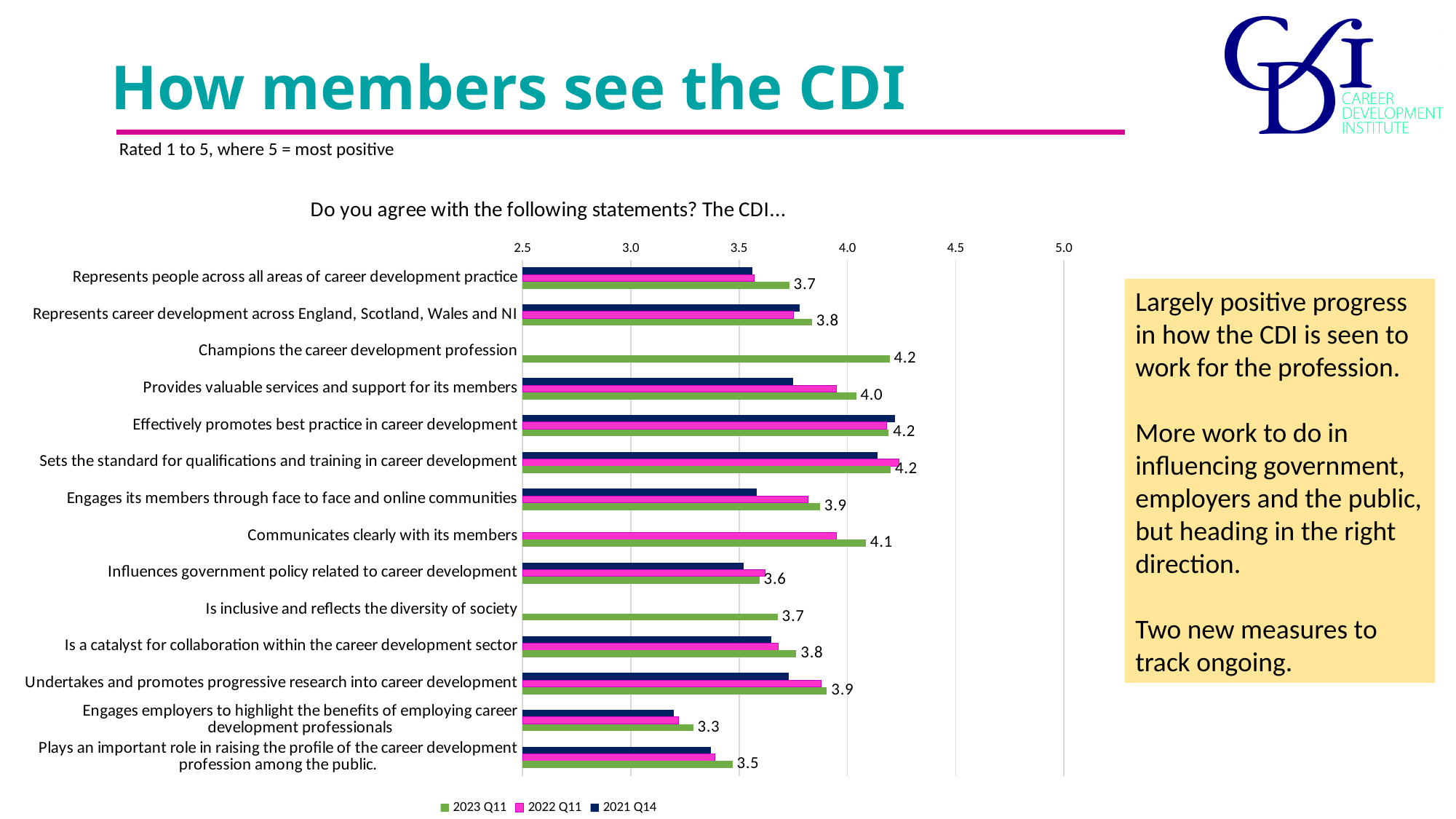
How many series does the legend list? 3 What is the difference between the 2023 Q11 values for "Communicates clearly with its members" and "Influences government policy related to career development"? 0.5 What is the 2023 Q11 value for "Champions the career development profession"? 4.2 How many statements are listed on the chart? 14 Which statement has the lowest 2023 Q11 value? Engages employers to highlight the benefits of employing career development professionals What is the 2023 Q11 value for "Communicates clearly with its members"? 4.1 Is the 2021 Q14 value for "Effectively promotes best practice in career development" greater or less than 4.0? greater What is the difference between the 2023 Q11 values for "Champions the career development profession" and "Engages employers to highlight the benefits of employing career development professionals"? 0.9 What is the 2023 Q11 value for "Engages employers to highlight the benefits of employing career development professionals"? 3.3 Is the 2021 Q14 value for "Engages employers to highlight the benefits of employing career development professionals" greater or less than 3.5? less Which has the higher 2023 Q11 value: "Communicates clearly with its members" or "Engages its members through face to face and online communities"? Communicates clearly with its members What kind of chart is shown on the slide? Bar chart